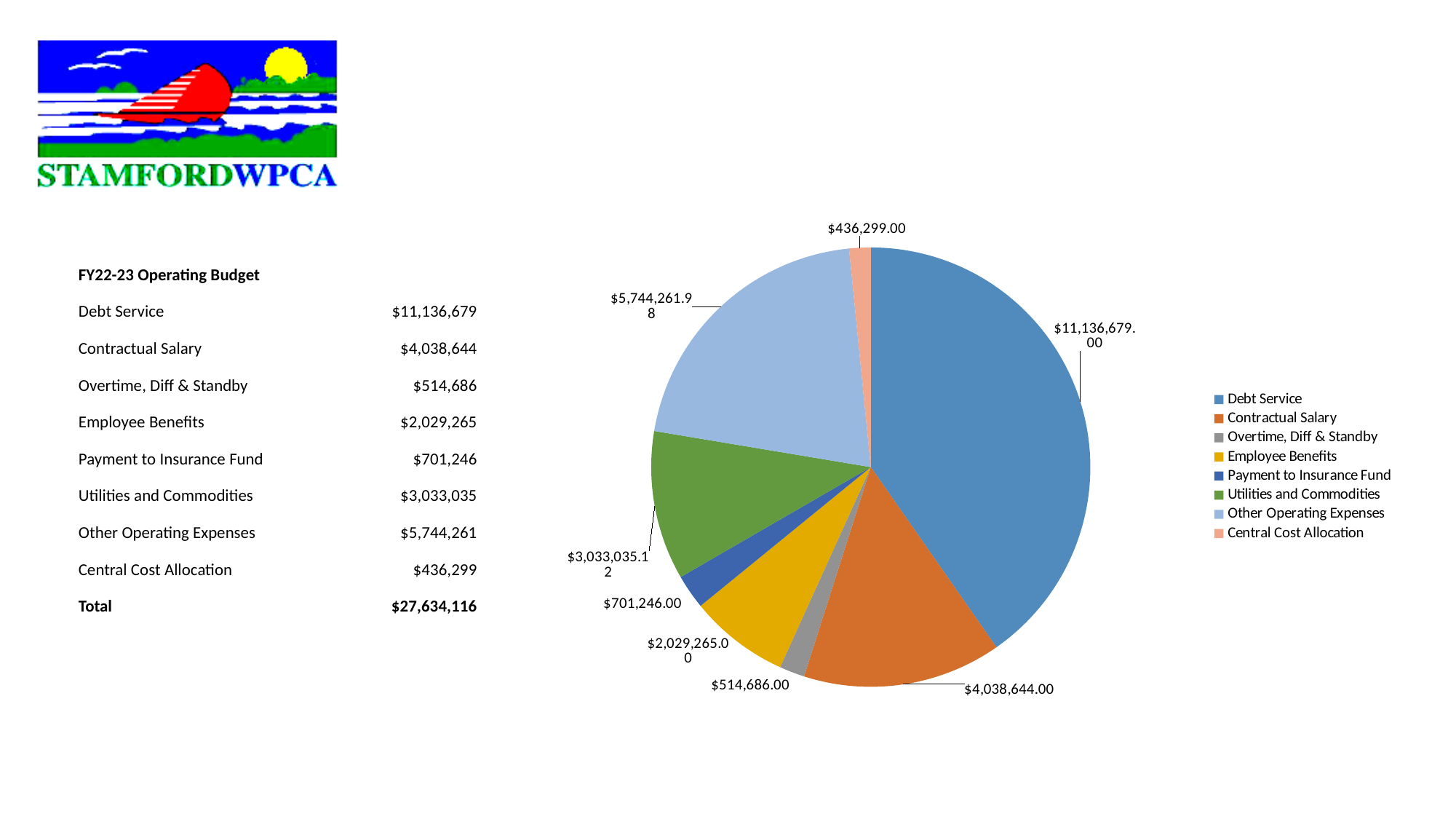
How many slices does the pie chart have? 8 What value does the pie chart's data label show for Other Operating Expenses? $5,744,261.98 What colour is the Debt Service slice in the pie chart? blue In the pie chart, which is larger: Other Operating Expenses or Contractual Salary? Other Operating Expenses In the pie chart, which is larger: Payment to Insurance Fund or Overtime, Diff & Standby? Payment to Insurance Fund What value does the pie chart's data label show for Employee Benefits? $2,029,265.00 Which category has the smallest slice in the pie chart? Central Cost Allocation What kind of chart is shown on the slide? pie chart According to the pie chart's data labels, how much larger is Debt Service than Contractual Salary? $7,098,035.00 What value does the pie chart's data label show for Utilities and Commodities? $3,033,035.12 How many entries does the pie chart's legend list? 8 Which category has the largest slice in the pie chart? Debt Service